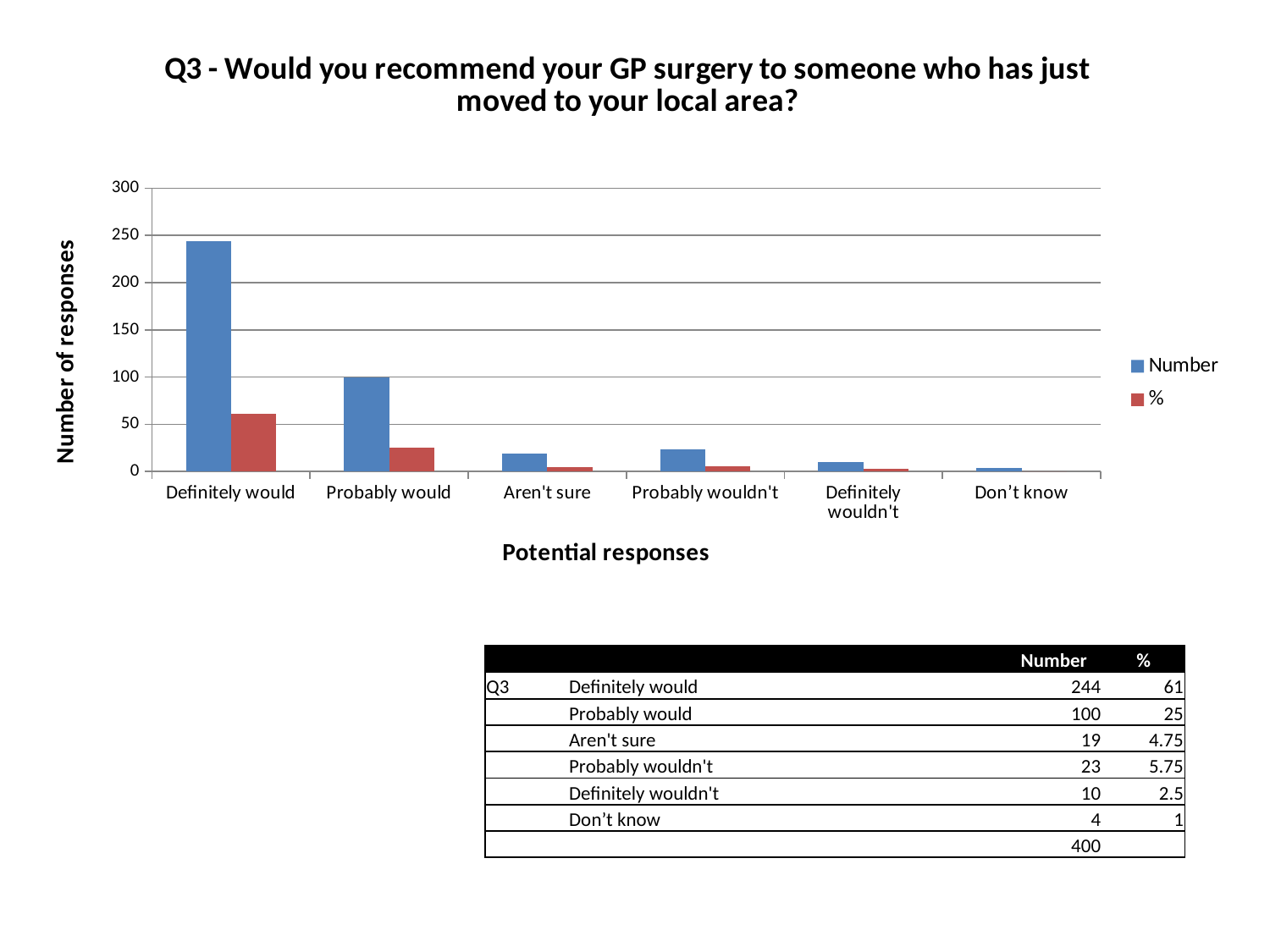
What is the Number value for 'Probably wouldn't'? 23 What is the Number value for 'Definitely would'? 244 How many response categories are shown on the x axis of the chart? 6 Which category has the lowest Number of responses? Don't know Is the Number value for 'Definitely would' greater or less than 200? greater What is the label of the y axis of the chart? Number of responses Which category has the highest Number of responses? Definitely would How many series does the chart legend list? 2 What is the % value for 'Probably would'? 25 Which has a larger Number of responses, 'Aren't sure' or 'Probably wouldn't'? Probably wouldn't What is the difference in Number between 'Definitely would' and 'Probably would'? 144 What type of chart is shown on the slide? bar chart